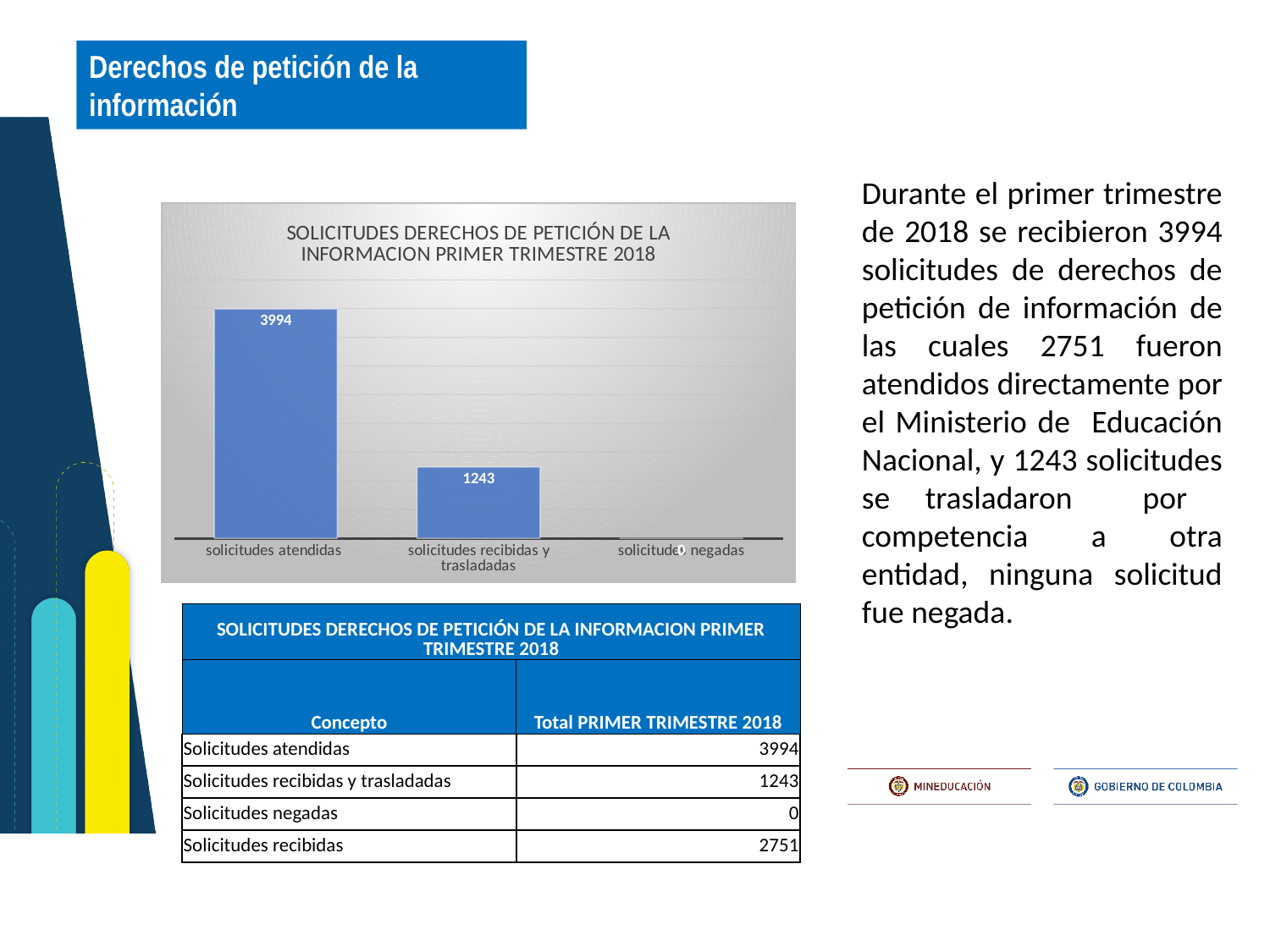
What is the value for solicitudes recibidas y trasladadas in the chart? 1243 What is the difference between the values for solicitudes atendidas and solicitudes recibidas y trasladadas? 2751 How many categories are shown in the chart? 3 What kind of chart is shown on the slide? bar chart Which is larger: solicitudes atendidas or solicitudes recibidas y trasladadas? solicitudes atendidas Which category has the lowest value in the chart? solicitudes negadas What is the value for solicitudes atendidas in the chart? 3994 Do the values rise or fall from left to right across the categories? fall What is the total of solicitudes atendidas and solicitudes recibidas y trasladadas in the chart? 5237 What is the value for solicitudes negadas in the chart? 0 What is the title of the chart? SOLICITUDES DERECHOS DE PETICIÓN DE LA INFORMACION PRIMER TRIMESTRE 2018 Which category has the highest value in the chart? solicitudes atendidas